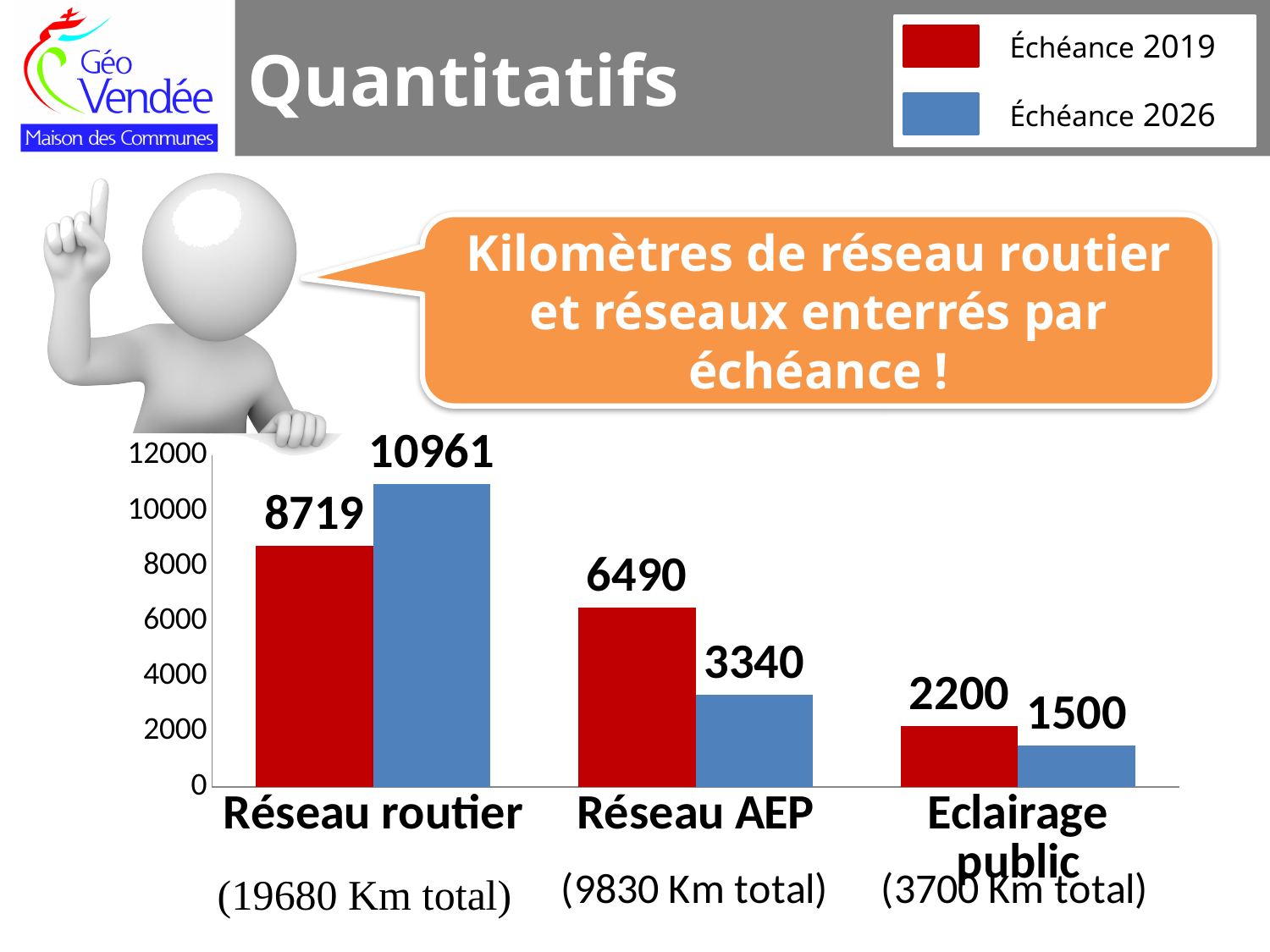
Which is larger for Réseau routier: the Échéance 2019 value or the Échéance 2026 value? Échéance 2026 What is the value for Réseau routier in the Échéance 2026 series? 10961 What is the value for Réseau routier in the Échéance 2019 series? 8719 How many categories are shown on the x axis? 3 How many series does the legend list? 2 Which category has the lowest Échéance 2019 value? Eclairage public Which colour represents the Échéance 2019 series? Red What is the value for Réseau AEP in the Échéance 2019 series? 6490 What is the difference between the Échéance 2019 and Échéance 2026 values for Réseau AEP? 3150 Which category has the highest Échéance 2026 value? Réseau routier What kind of chart is shown on the slide? Bar chart What is the value for Eclairage public in the Échéance 2026 series? 1500